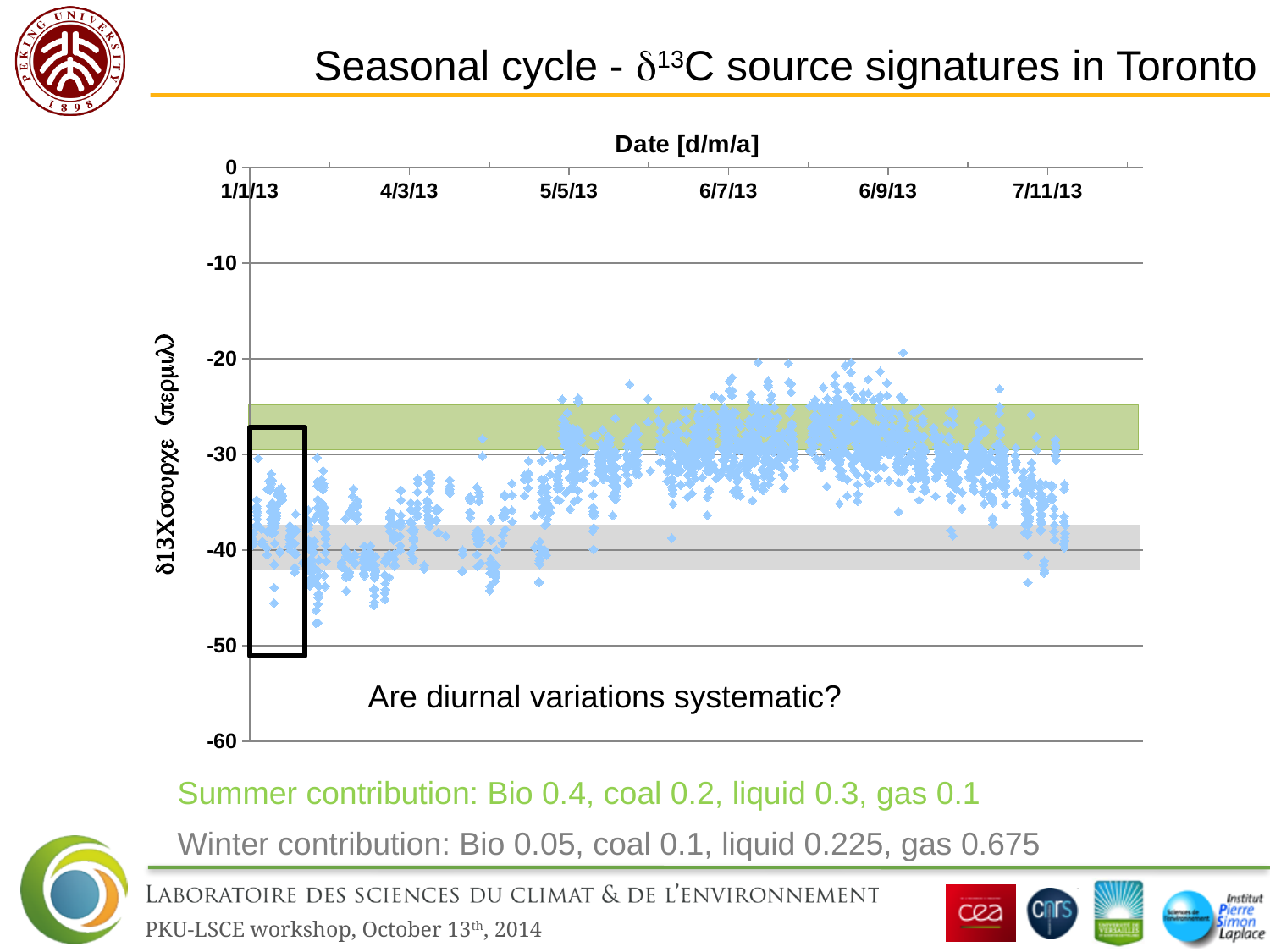
Do the plotted values generally rise or fall from 1/1/13 to 6/7/13? rise What kind of chart is shown on the slide? scatter plot What is the title of the x axis of the chart? Date [d/m/a] Are the plotted values around 1/1/13 greater or less than -30? less What is the highest value shown on the y axis of the chart? 0 What is the first date label on the x axis of the chart? 1/1/13 How many date labels are shown along the x axis of the chart? 6 Which period has higher plotted values, around 1/1/13 or around 6/9/13? around 6/9/13 Are the plotted values around 6/9/13 greater or less than -40? greater Are the plotted values around 6/7/13 greater or less than -40? greater